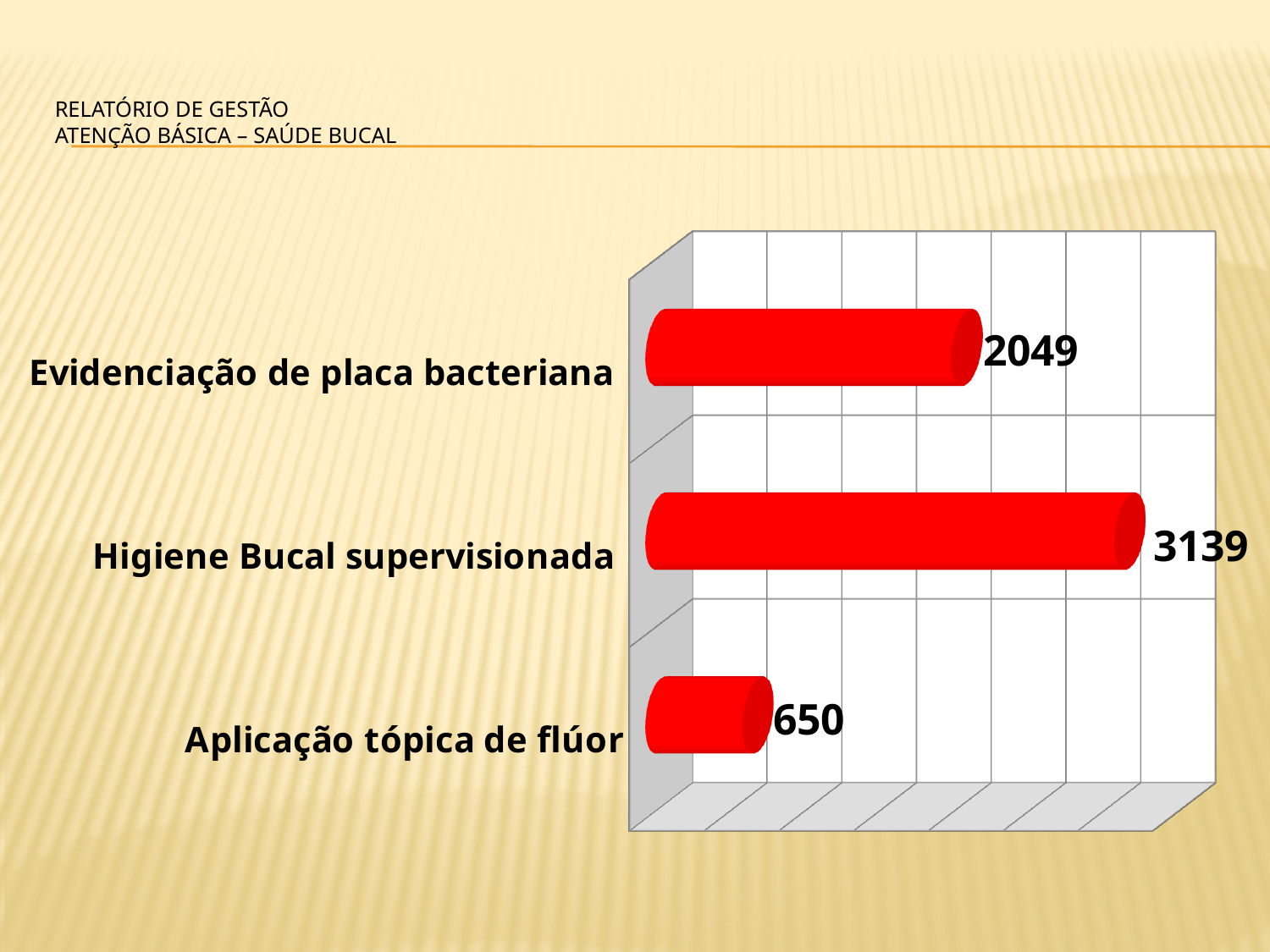
Which category has the highest value? Higiene Bucal supervisionada What is the difference between the values for Evidenciação de placa bacteriana and Aplicação tópica de flúor? 1399 What is the value for Evidenciação de placa bacteriana? 2049 What is the value for Higiene Bucal supervisionada? 3139 What kind of chart is shown on the slide? bar chart Which category has the lowest value? Aplicação tópica de flúor What is the total of the three values shown in the chart? 5838 Which is larger: the value for Evidenciação de placa bacteriana or the value for Aplicação tópica de flúor? Evidenciação de placa bacteriana How many categories are shown in the chart? 3 What is the difference between the values for Higiene Bucal supervisionada and Evidenciação de placa bacteriana? 1090 What colour are the bars in the chart? red What is the value for Aplicação tópica de flúor? 650